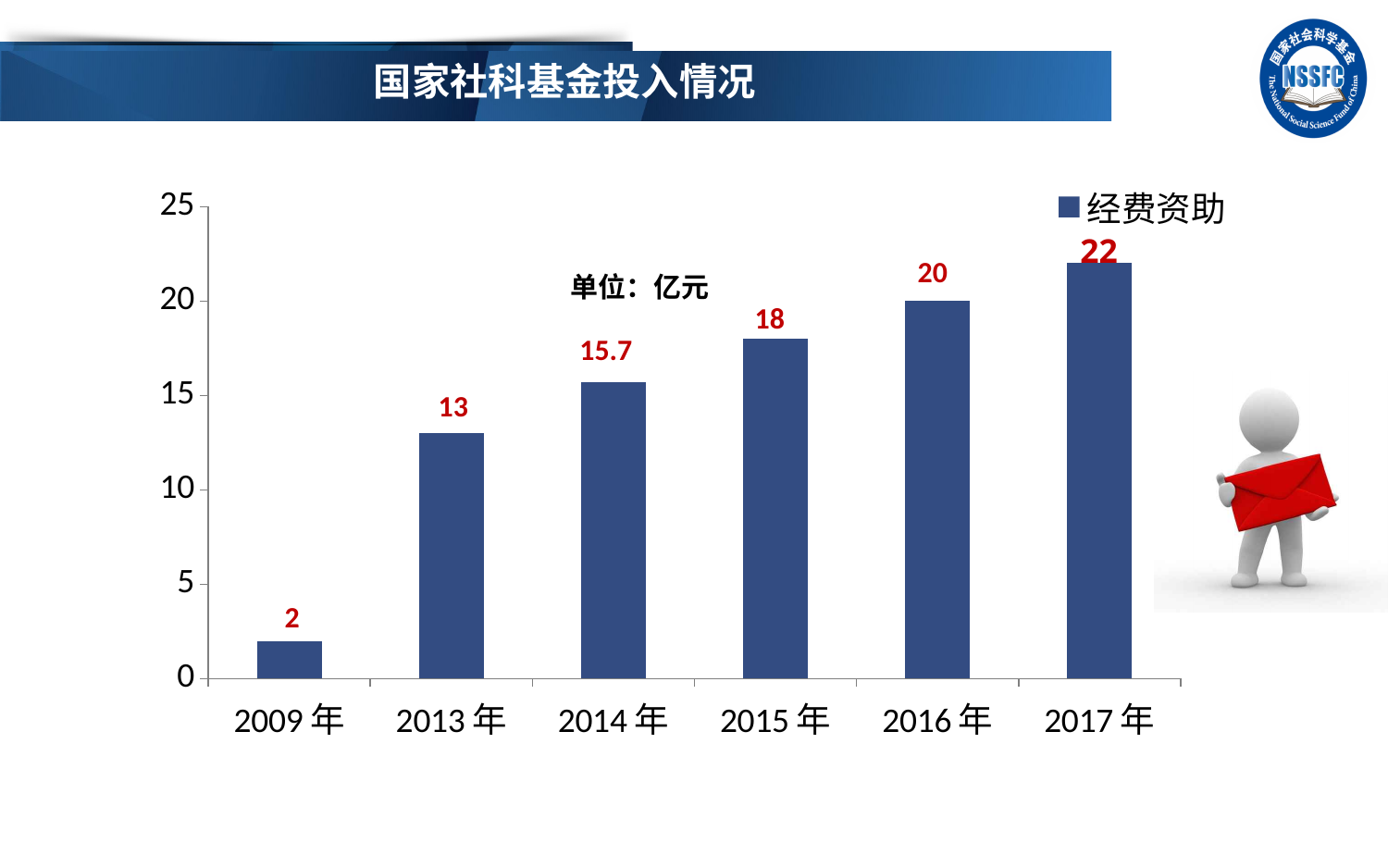
How many years are shown on the x axis? 6 Which year has the highest value? 2017年 Which is larger, the value for 2013年 or the value for 2015年? 2015年 How many series does the legend list? 1 What kind of chart is shown? bar chart Do the values rise or fall from 2009年 to 2017年? rise Which year has the lowest value? 2009年 What is the difference between the values for 2017年 and 2013年? 9 What is the value for 2009年? 2 What is the value for 2016年? 20 What is the difference between the values for 2015年 and 2014年? 2.3 What is the value for 2014年? 15.7